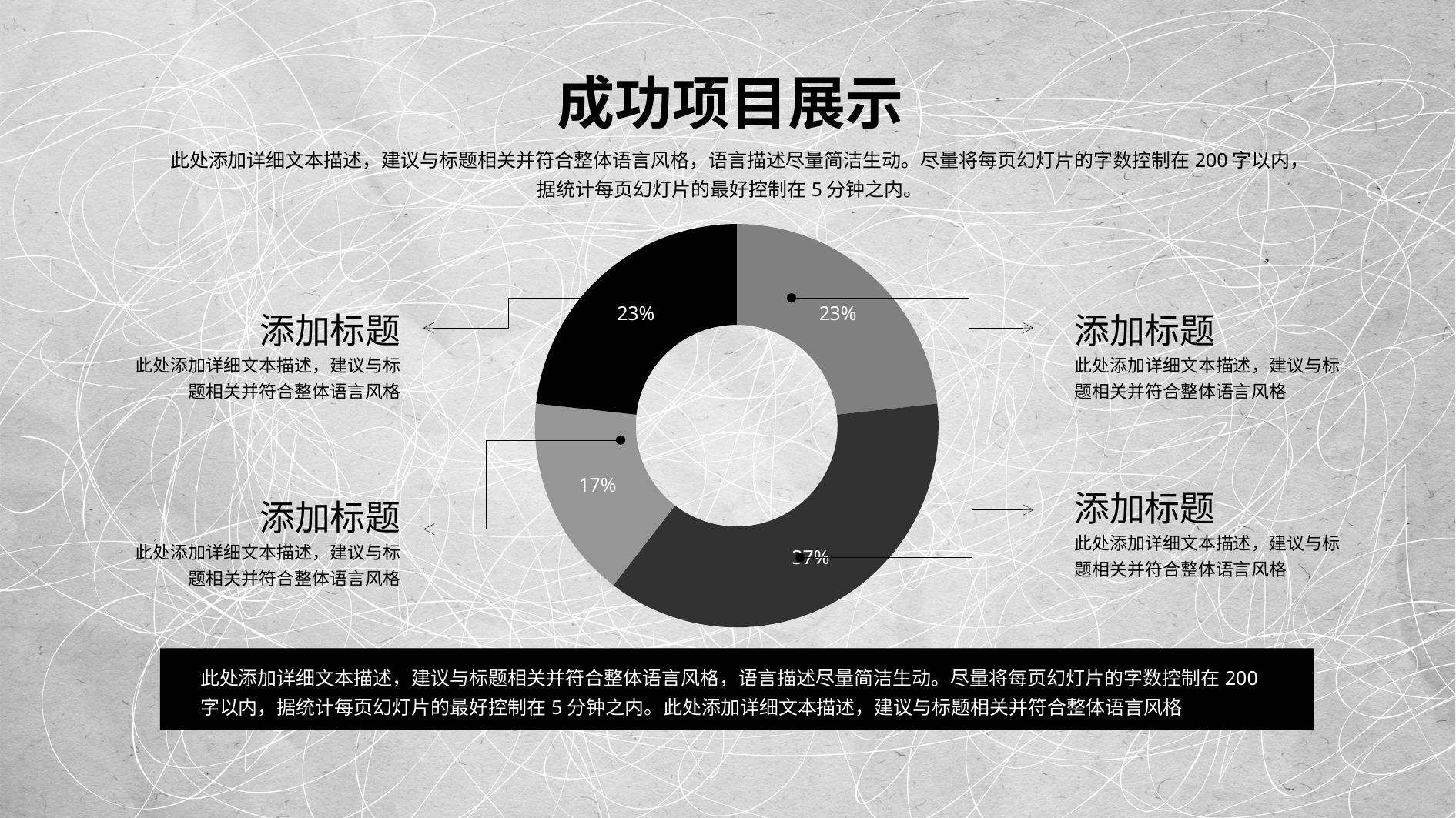
Which is larger, the bottom-right dark grey slice or the left light grey slice? the bottom-right dark grey slice What is the smallest percentage shown on the doughnut chart? 17% What is the largest percentage shown on the doughnut chart? 37% What do the four slice percentages add up to? 100% What percentage is labelled on the light grey slice on the left side of the doughnut? 17% What is the title of the slide containing the doughnut chart? 成功项目展示 What kind of chart is shown on the slide? doughnut chart How many slices are labelled 23%? 2 What percentage is labelled on the dark grey slice at the bottom right of the doughnut? 37% How many slices does the doughnut chart have? 4 What is the difference between the largest slice (37%) and the smallest slice (17%)? 20% What percentage is labelled on the black slice at the top left of the doughnut? 23%